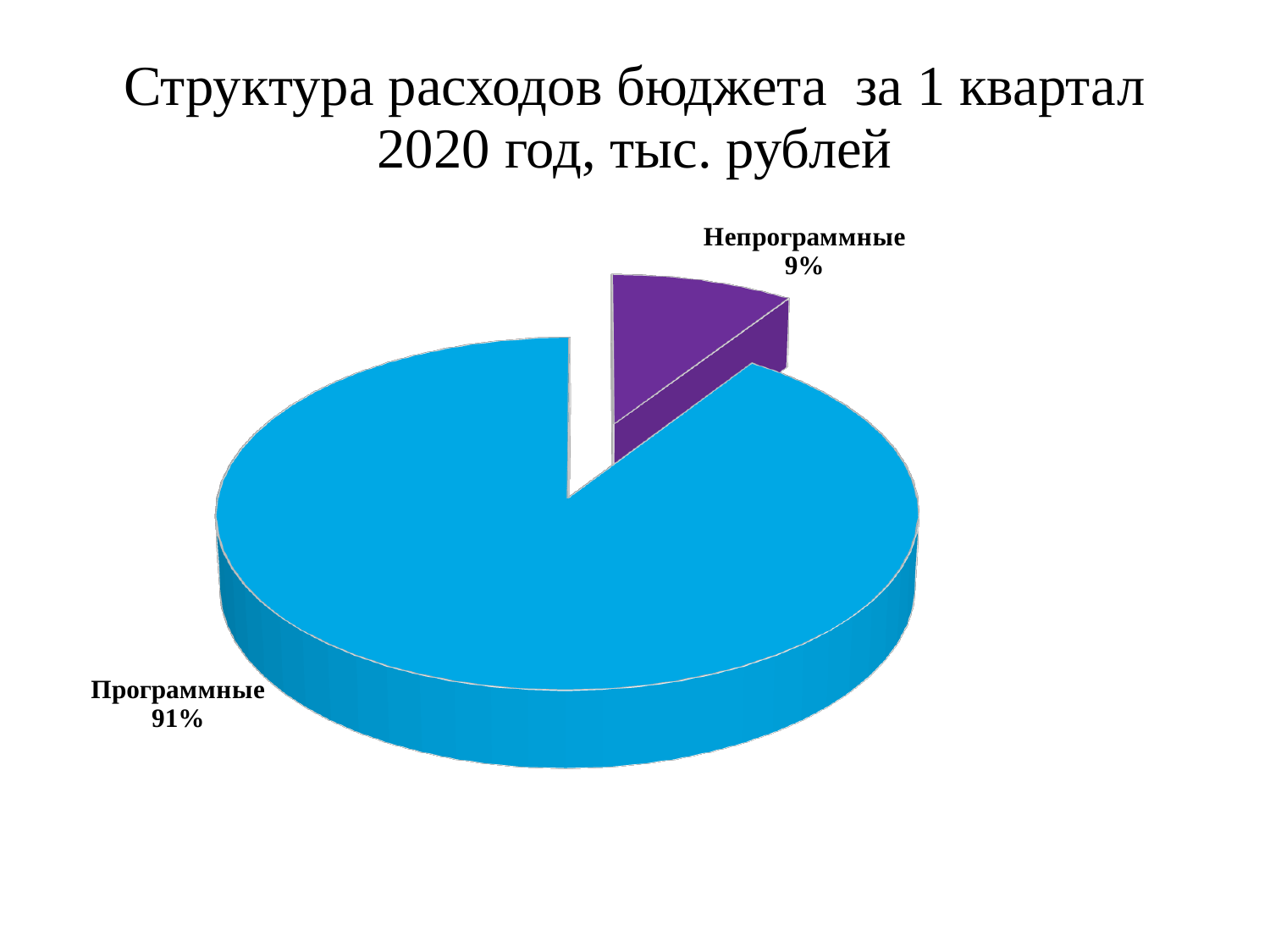
What is the title of the slide? Структура расходов бюджета за 1 квартал 2020 год, тыс. рублей What kind of chart is shown on the slide? Pie chart Which slice is larger, Программные or Непрограммные? Программные What is the difference in percentage points between the Программные and Непрограммные slices? 82 What colour is the Непрограммные slice? Purple What share of the pie does the Программные slice represent? 91% What share of the pie does the Непрограммные slice represent? 9% Which category has the smallest slice of the pie? Непрограммные How many slices does the pie chart have? 2 Which category has the largest slice of the pie? Программные